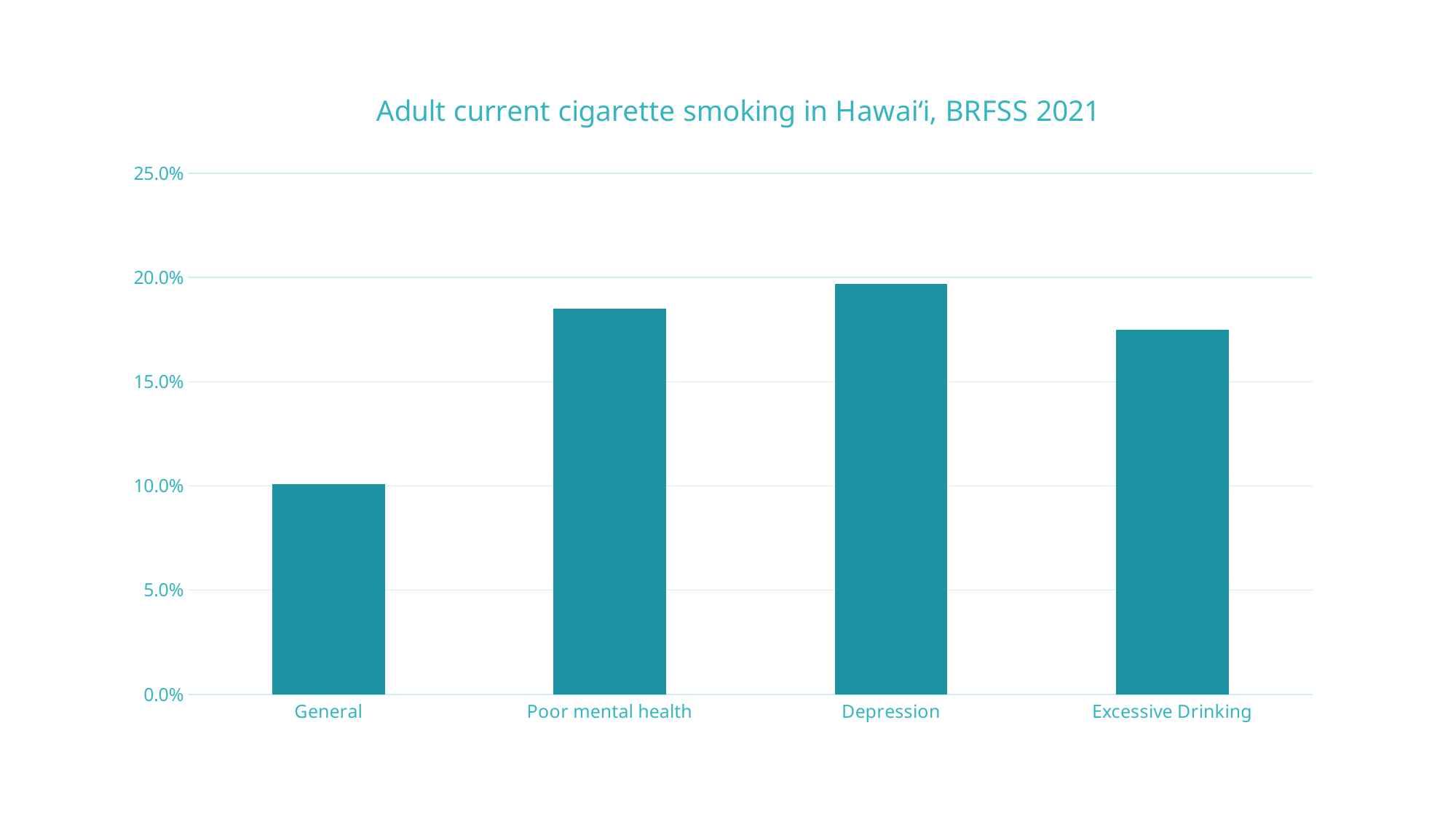
How many categories are shown on the x axis? 4 Which is larger, the value for General or the value for Poor mental health? Poor mental health Is the value for Poor mental health greater or less than 15.0%? greater Is the value for Excessive Drinking greater or less than 20.0%? less Is the value for General greater or less than 15.0%? less What kind of chart is shown on the slide? bar chart Which category has the lowest smoking rate? General Which category has the highest smoking rate? Depression Which is larger, the value for Depression or the value for Excessive Drinking? Depression What is the title of the chart? Adult current cigarette smoking in Hawai‘i, BRFSS 2021